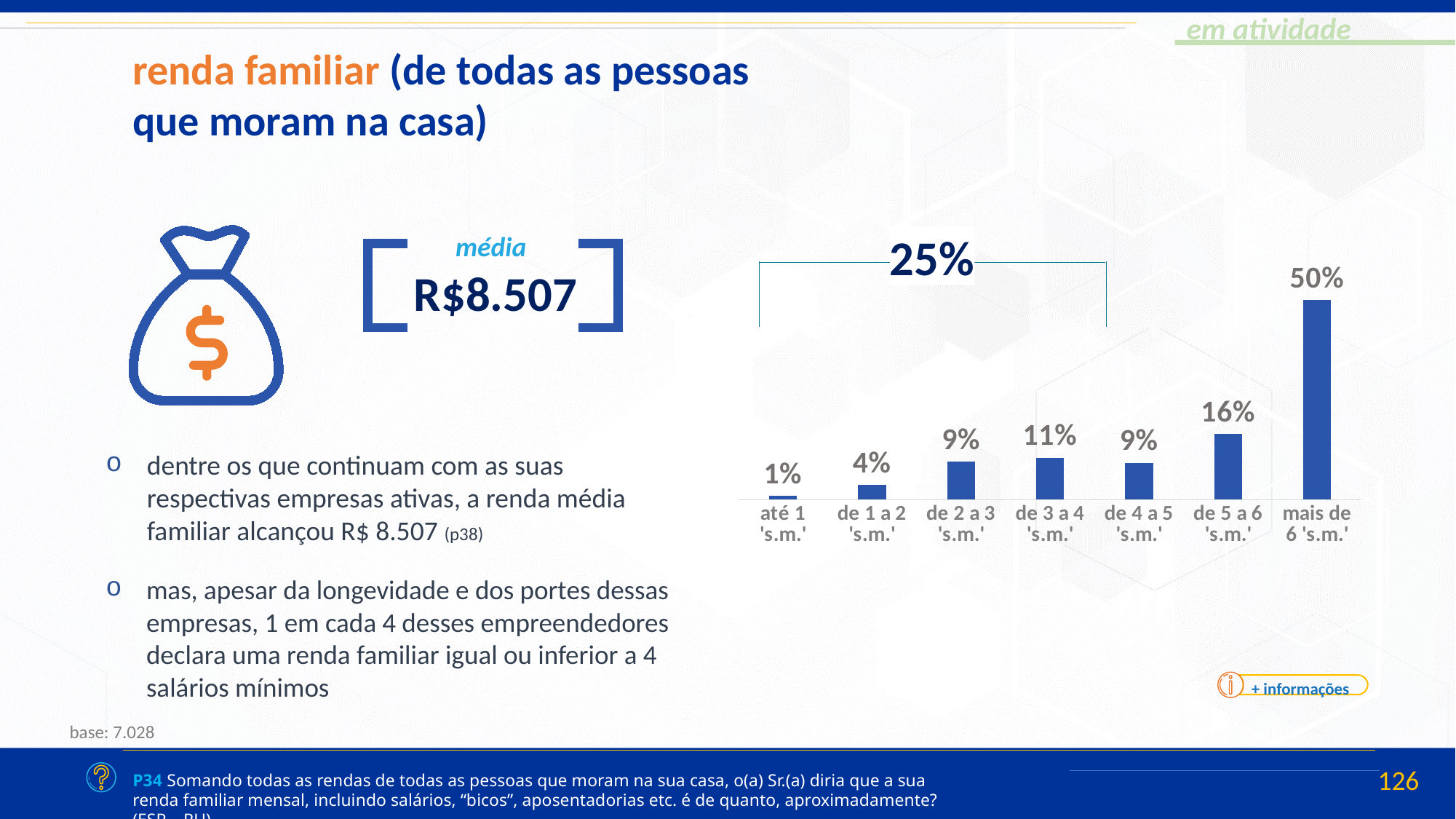
What is the combined value of the 'de 1 a 2 s.m.' and 'de 2 a 3 s.m.' categories? 13% How many categories are shown on the chart? 7 What is the value for the 'de 3 a 4 s.m.' category? 11% What kind of chart is shown on the slide? bar chart What is the value for the 'até 1 s.m.' category? 1% Which category has the lowest value? até 1 's.m.' What percentage is shown by the bracket spanning the first four categories of the chart? 25% Which category has the highest value? mais de 6 's.m.' Which is larger, the value for 'de 3 a 4 s.m.' or the value for 'de 4 a 5 s.m.'? de 3 a 4 's.m.' What is the difference between the values for 'mais de 6 s.m.' and 'de 5 a 6 s.m.'? 34 percentage points What is the value for the 'de 5 a 6 s.m.' category? 16% What percentage is shown for the 'mais de 6 s.m.' category? 50%